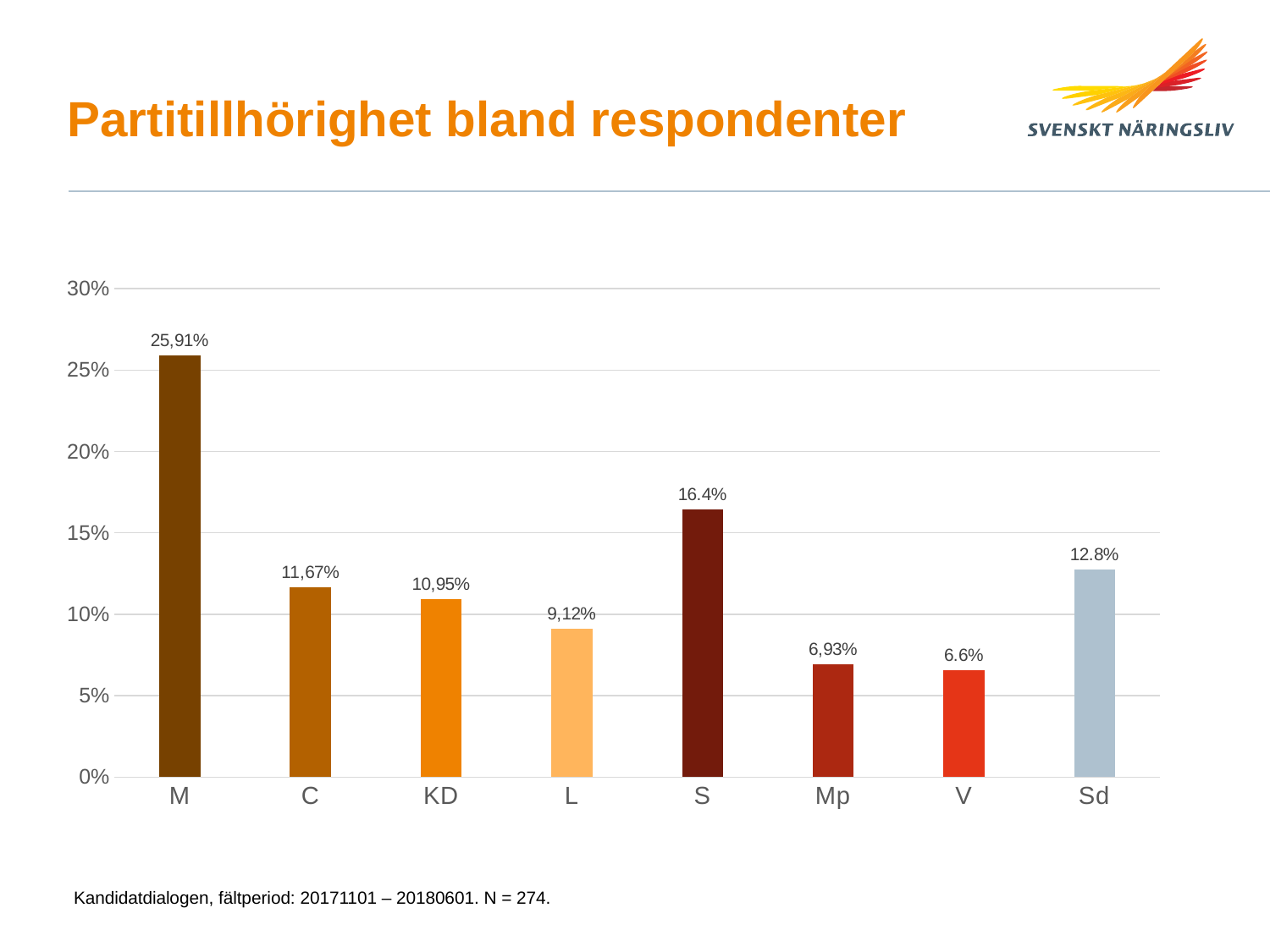
What is the value for M? 25,91% How many parties are shown on the x axis? 8 Which party has the highest share of respondents? M What is the title of the slide? Partitillhörighet bland respondenter Which party has the lowest share of respondents? V What is the value for Sd? 12.8% What is the difference between the values for C and KD? 0,72% What is the value for KD? 10,95% What is the difference between the values for S and Sd? 3.6% Which is larger, the value for L or the value for Mp? L What is the value for S? 16.4% What kind of chart is shown on the slide? Bar chart